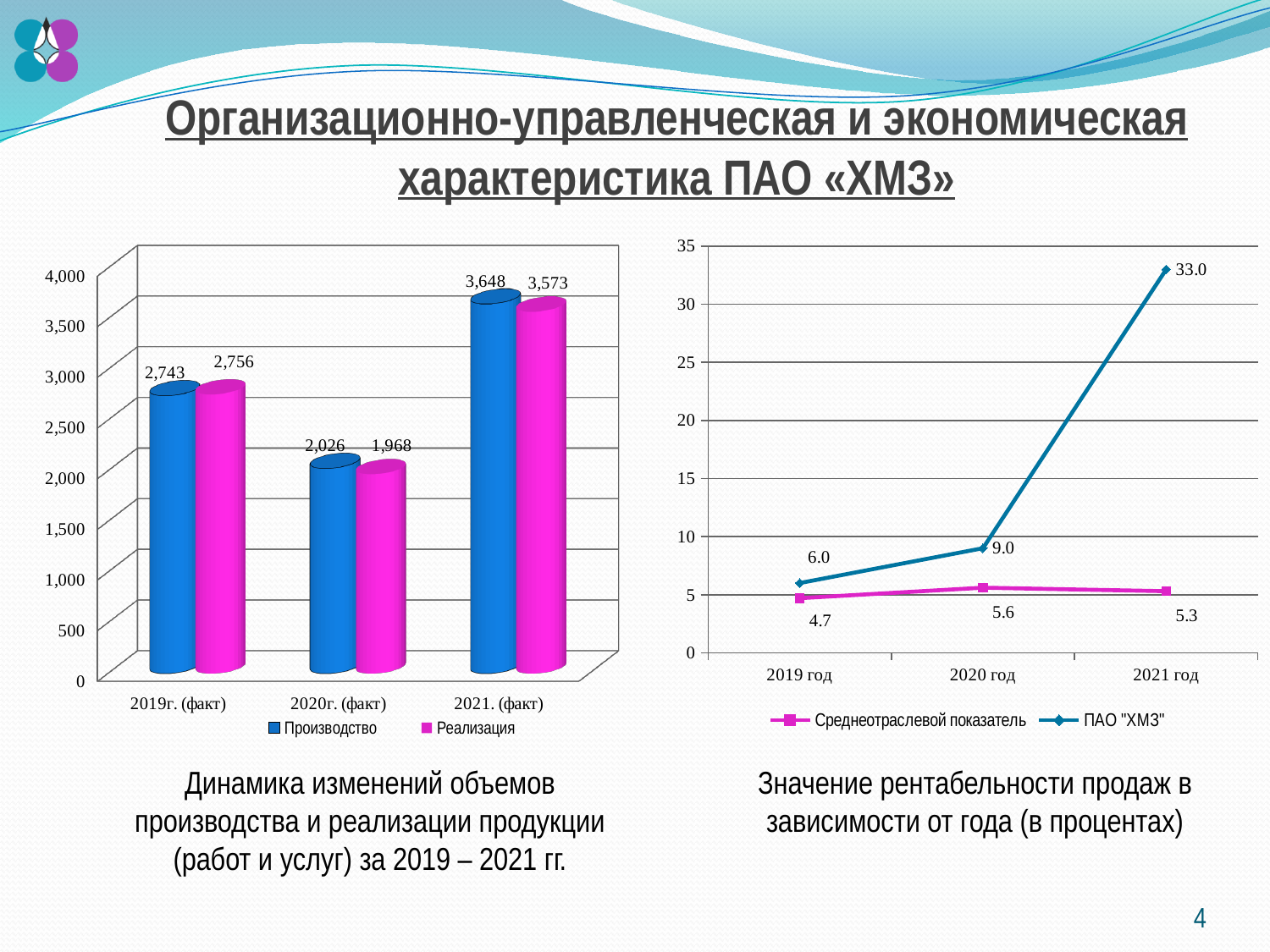
In the right chart, does the ПАО "ХМЗ" series rise or fall from 2019 год to 2021 год? Rise In the right chart, how many years are shown on the x axis? 3 In the left chart, what is the value of Реализация for 2020г. (факт)? 1,968 In the right chart, what is the value of Среднеотраслевой показатель for 2019 год? 4.7 What kind of chart is the left chart? Bar chart In the left chart, how many series does the legend list? 2 In the right chart, what is the difference between ПАО "ХМЗ" and Среднеотраслевой показатель in 2020 год? 3.4 In the left chart, what is the difference between Производство and Реализация for 2021. (факт)? 75 In the left chart, which year has the highest Производство value? 2021. (факт) In the left chart, which year has the lowest Реализация value? 2020г. (факт) In the right chart, what is the value of ПАО "ХМЗ" for 2021 год? 33.0 In the left chart, what is the value of Производство for 2019г. (факт)? 2,743